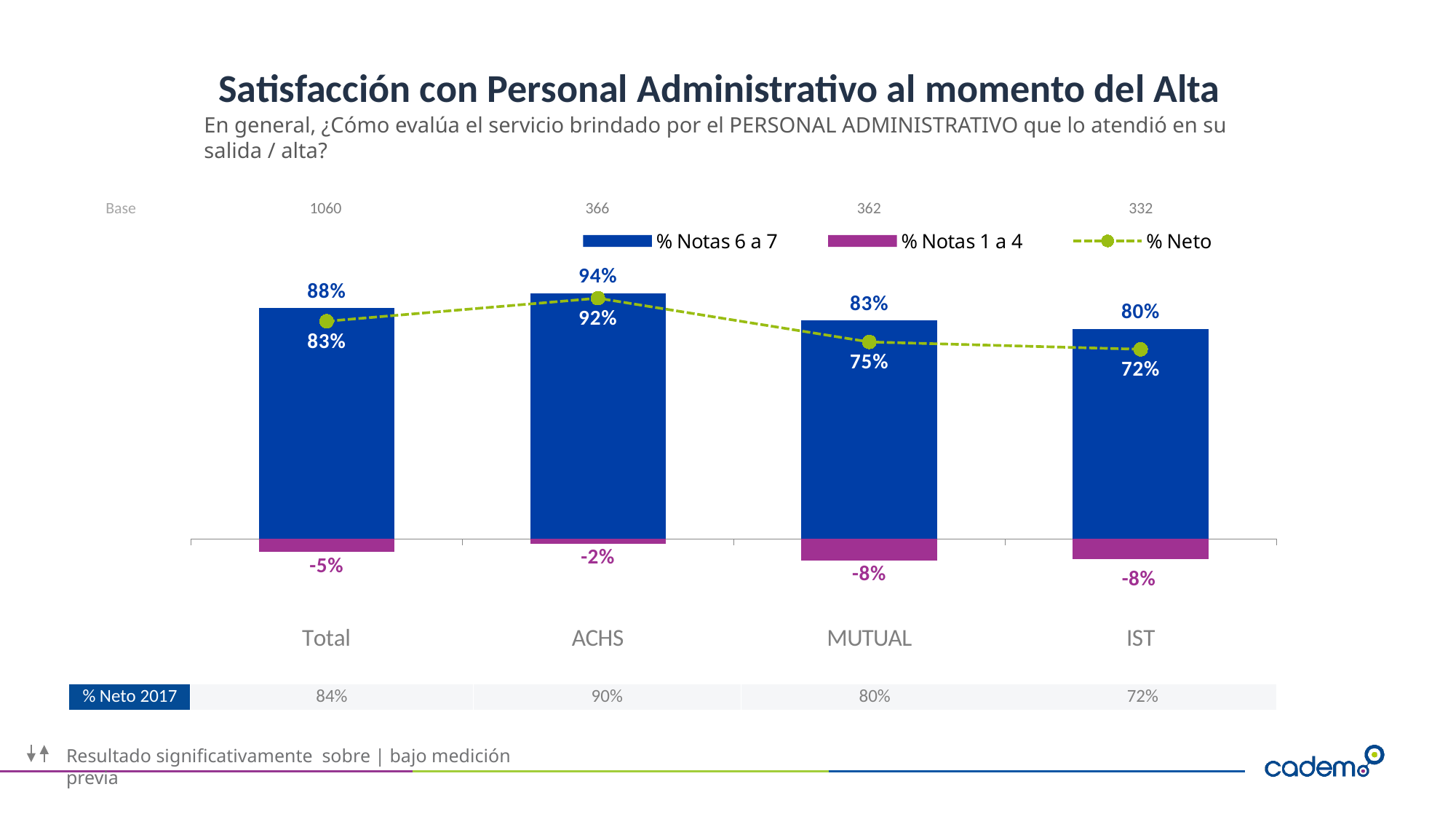
How many categories are shown on the x axis? 4 Which category has the lowest % Neto value? IST What is the % Notas 6 a 7 value for ACHS? 94% Which category has the highest % Notas 6 a 7 value? ACHS What kind of chart is this? Bar chart with a line Which is larger, the % Neto value for Total or for MUTUAL? Total What is the difference between the % Notas 6 a 7 values for ACHS and IST? 14 percentage points Does the % Neto line rise or fall from ACHS to IST? Fall How many series does the legend list? 3 What is the % Neto value for MUTUAL? 75% What is the base (sample size) shown for MUTUAL? 362 What is the % Notas 1 a 4 value for Total? -5%